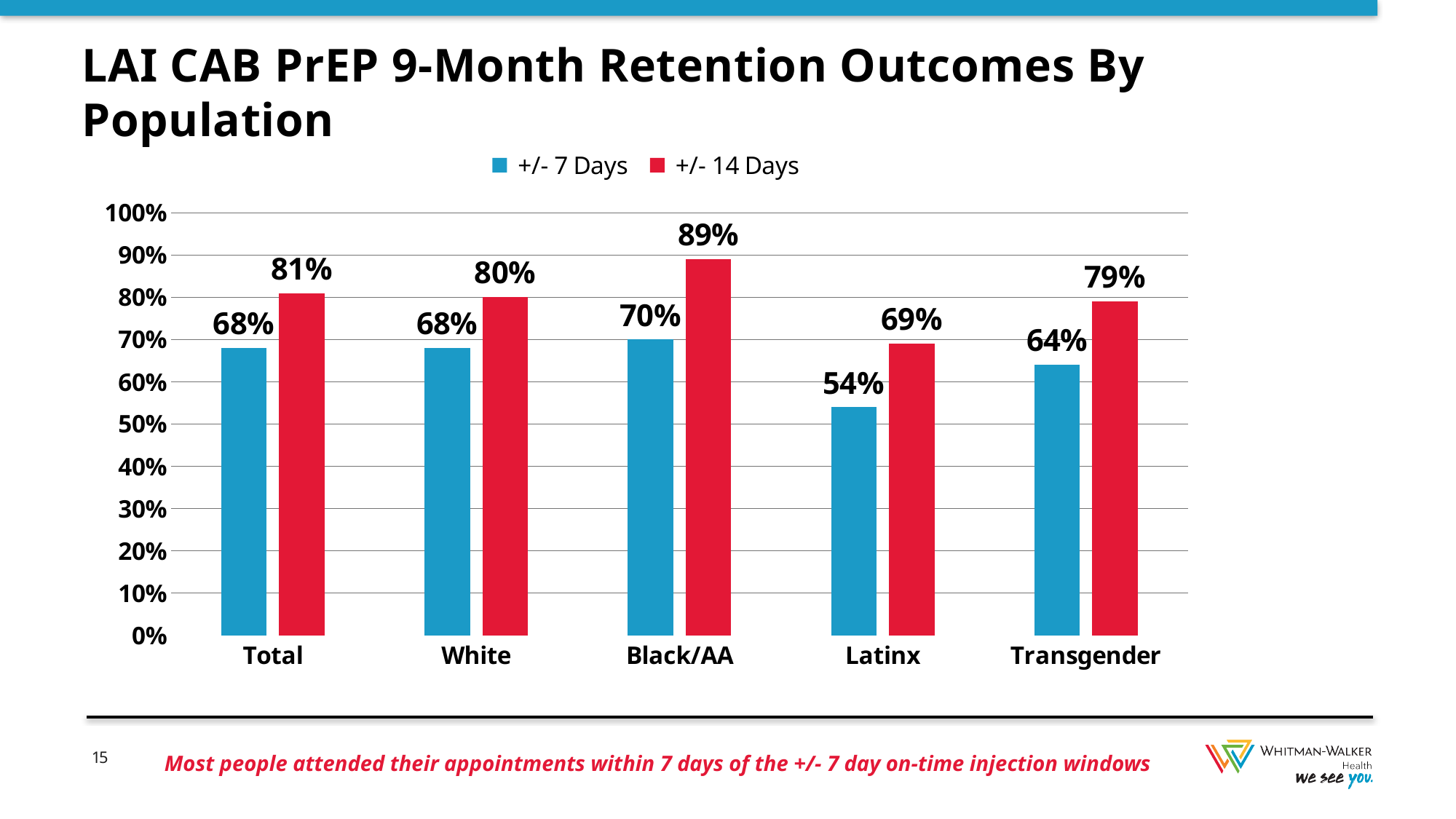
What is the +/- 14 Days value for Black/AA? 89% How many population categories are shown on the x axis? 5 What is the difference between the +/- 14 Days and +/- 7 Days values for Latinx? 15% What is the +/- 7 Days value for Latinx? 54% Which population has the highest +/- 14 Days value? Black/AA Which population has the lowest +/- 7 Days value? Latinx Which colour represents the +/- 14 Days series? Red What kind of chart is shown on the slide? Bar chart What is the +/- 7 Days value for Transgender? 64% Which is larger: the +/- 7 Days value for Black/AA or the +/- 7 Days value for Transgender? Black/AA How many series does the legend list? 2 Is the +/- 14 Days value for Transgender greater or less than 70%? greater